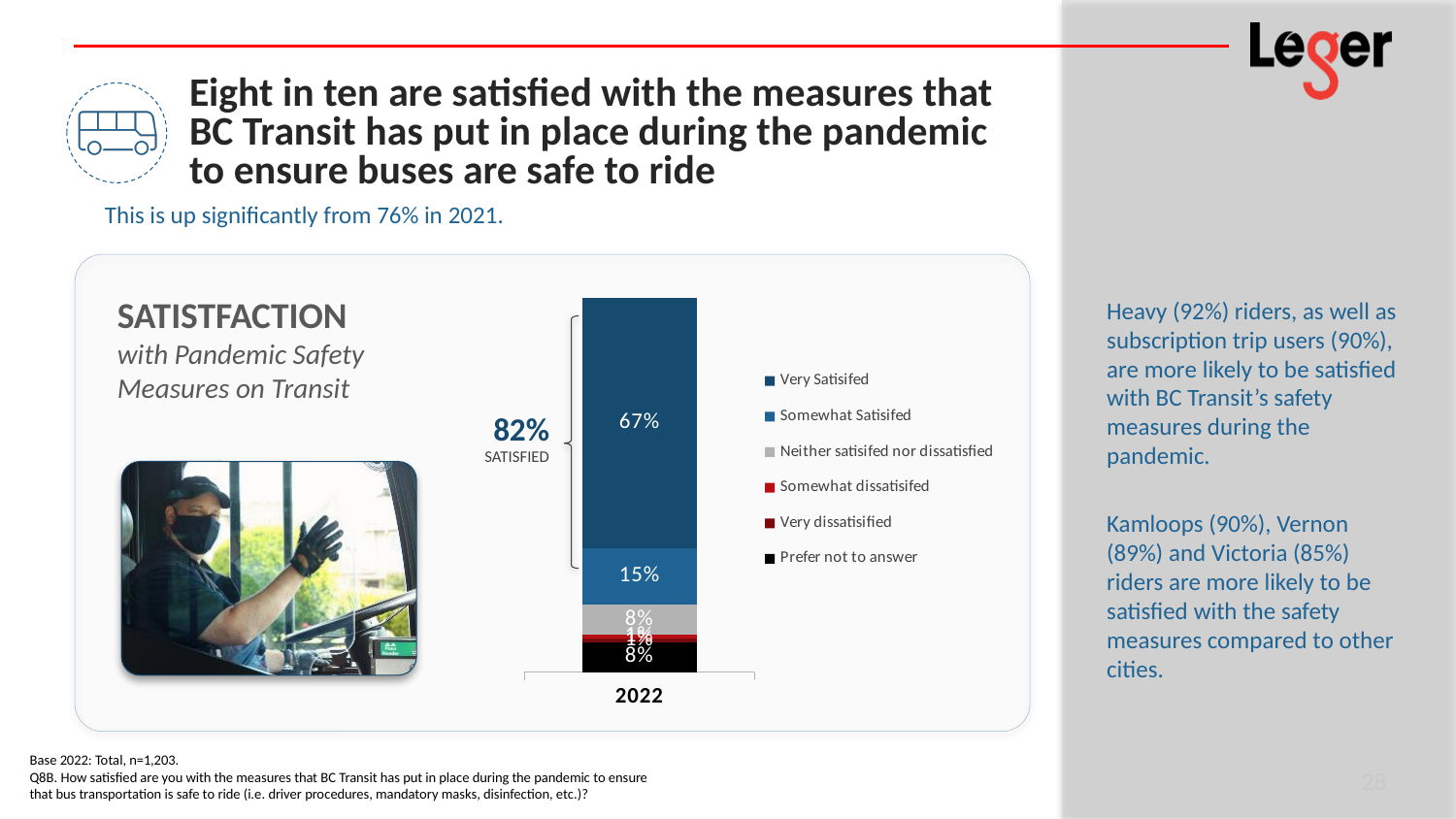
What is the difference between the Very Satisfied and Somewhat Satisfied values in 2022? 52 percentage points What is the value for Very Satisfied in 2022? 67% Which series has the largest segment in the 2022 bar? Very Satisfied How many categories are shown on the x axis of the chart? 1 How many series does the chart legend list? 6 Which is larger in 2022, Very Satisfied or Somewhat Satisfied? Very Satisfied What is the value for Somewhat Satisfied in 2022? 15% What kind of chart is shown on the slide? stacked bar chart What is the value for Prefer not to answer in 2022? 8% What is the value for Neither satisfied nor dissatisfied in 2022? 8% What combined satisfied percentage is shown by the bracket next to the bar? 82% What is the category label shown on the x axis of the chart? 2022